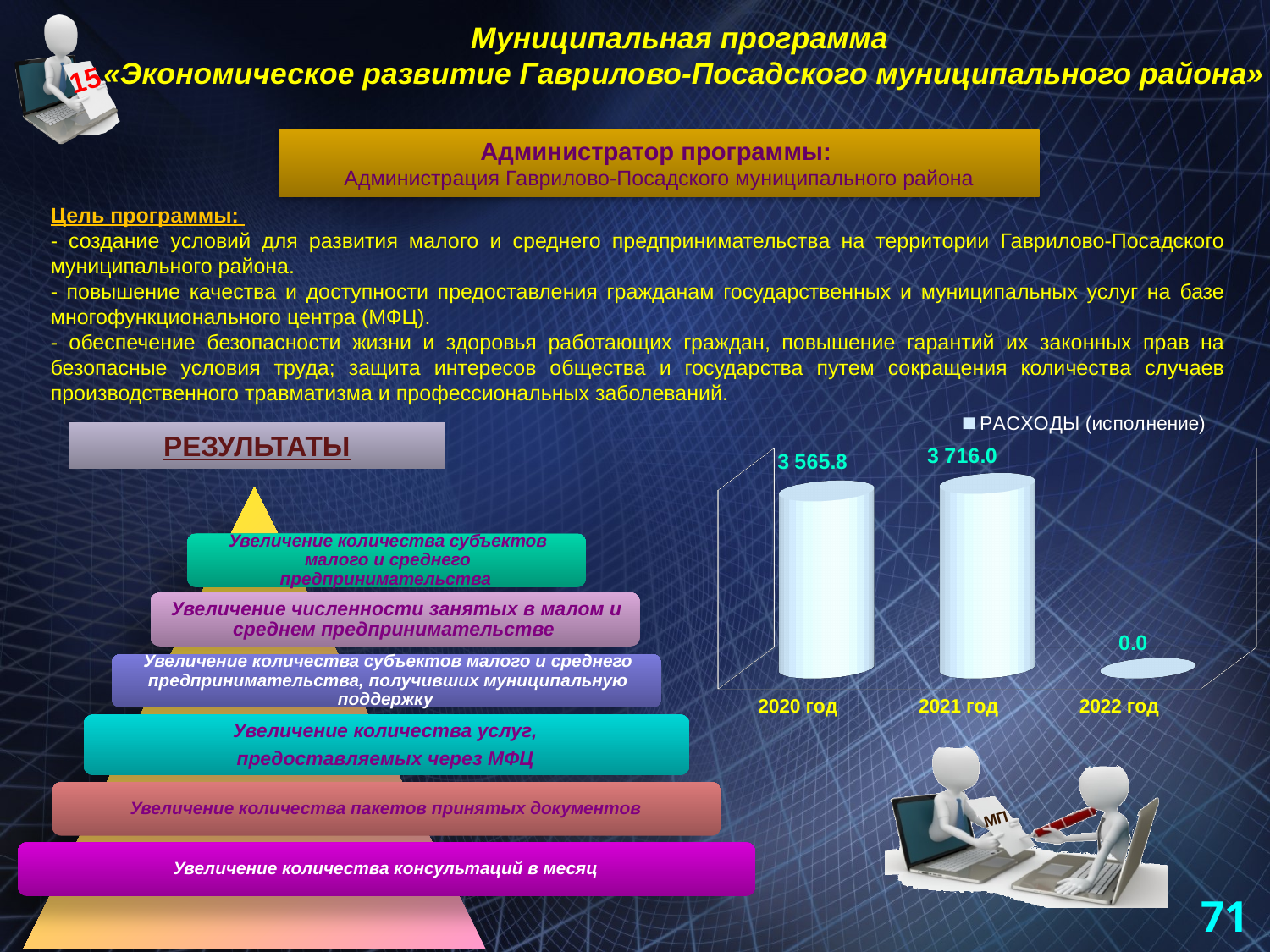
Which year has the highest value in the chart? 2021 год How many categories (years) are shown in the chart? 3 Which year has the lowest value in the chart? 2022 год How many series does the chart legend list? 1 What is the name of the series shown in the chart legend? РАСХОДЫ (исполнение) What is the value for 2021 год in the chart? 3 716.0 What is the value for 2020 год in the chart? 3 565.8 What is the difference between the values for 2021 год and 2020 год? 150.2 Which is larger, the value for 2020 год or the value for 2021 год? 2021 год Does the value rise or fall from 2020 год to 2021 год? Rise What is the value for 2022 год in the chart? 0.0 What kind of chart is shown on the slide? Bar chart